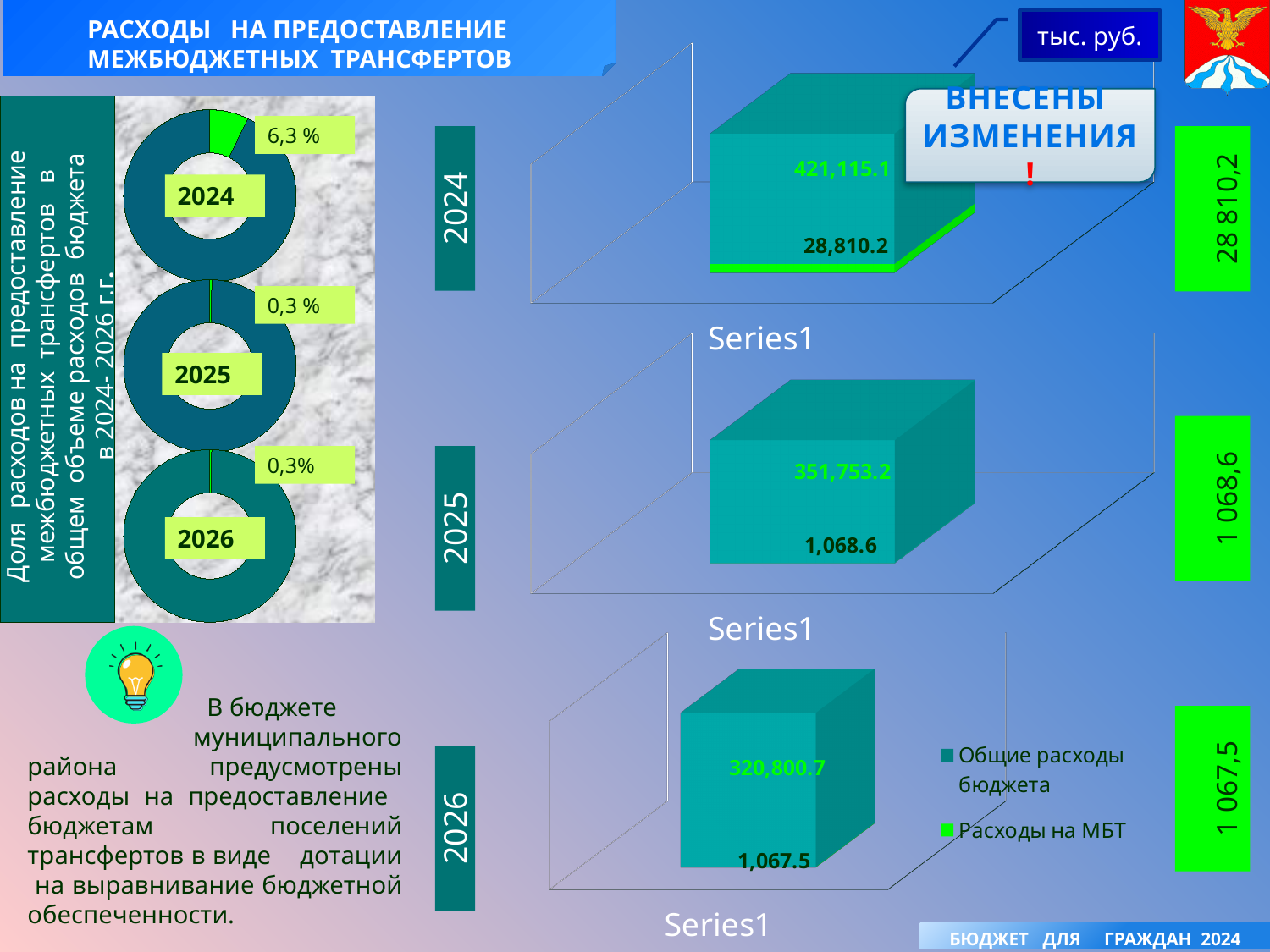
What unit is indicated for the values in the bar charts? тыс. руб. Across the three bar charts, which year has the lowest value for Общие расходы бюджета? 2026 In the 2025 donut chart, what share is shown for intergovernmental transfers? 0,3 % In the 2024 bar chart, what is the value for Общие расходы бюджета? 421,115.1 In the 2026 bar chart, what is the value for Общие расходы бюджета? 320,800.7 In the 2024 donut chart, what share of total budget expenses do intergovernmental transfers (МБТ) make up? 6,3 % How many series does the legend of the bar charts list? 2 In the 2025 bar chart, what is the value for Расходы на МБТ? 1,068.6 In the 2024 bar chart, what is the value for Расходы на МБТ? 28,810.2 Across the three bar charts, which year has the highest value for Расходы на МБТ? 2024 In the 2025 bar chart, what is the value for Общие расходы бюджета? 351,753.2 In the 2026 bar chart, what is the value for Расходы на МБТ? 1,067.5